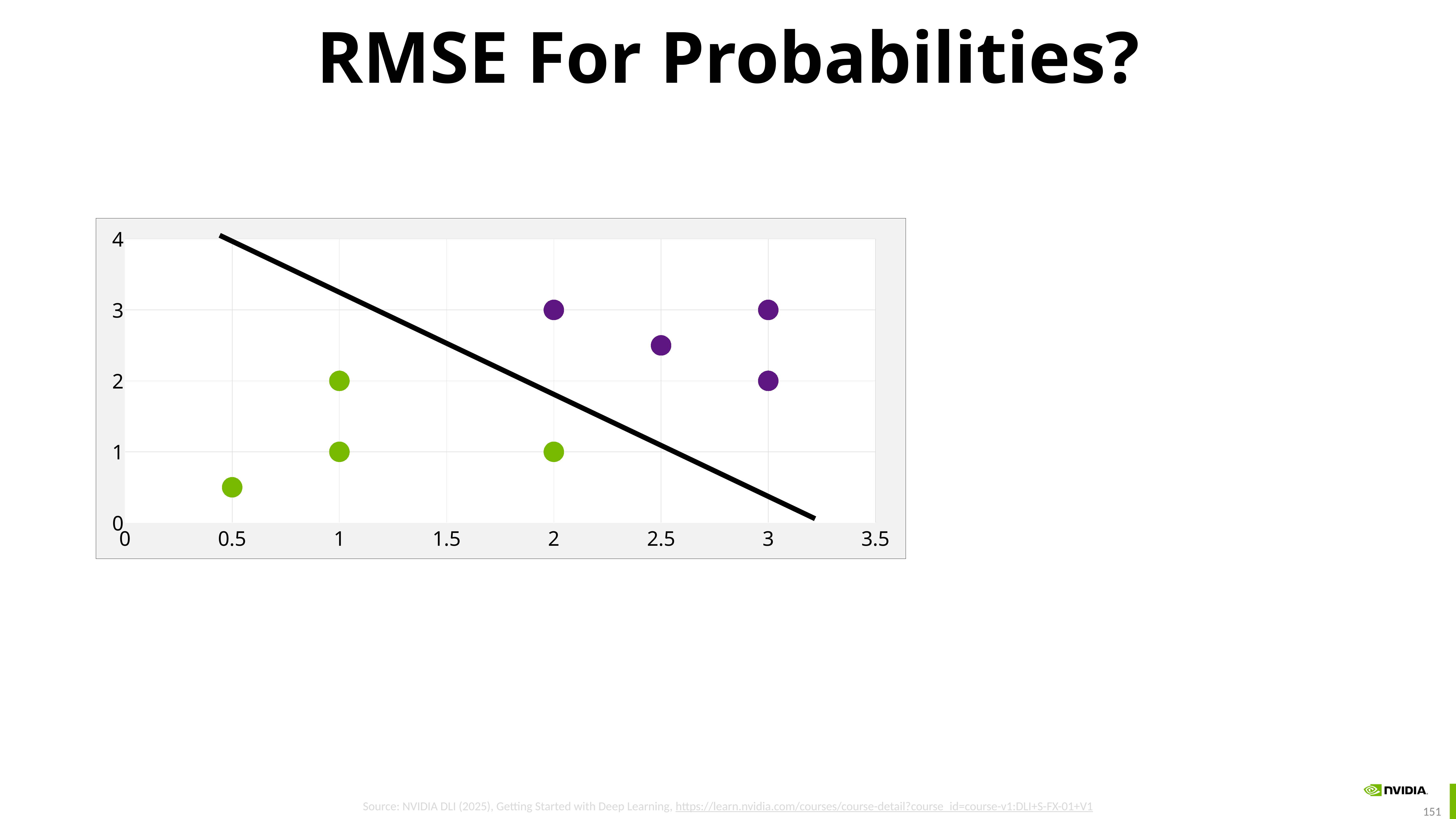
Does the black line rise or fall as x increases? Falls Which point is higher at x = 2, the green point or the purple point? The purple point What are the y values of the two purple points at x = 3? 2 and 3 What is the y value of the green point at x = 2? 1 Is the y value of the purple point at x = 2.5 greater or less than 2? greater What kind of chart is shown on the slide? Scatter plot What is the largest tick value shown on the x axis? 3.5 What is the y value of the purple point at x = 2? 3 How many data points are plotted on the chart? 8 Is the y value of the green point at x = 0.5 greater or less than 1? less How many purple points are plotted on the chart? 4 How many green points are plotted on the chart? 4